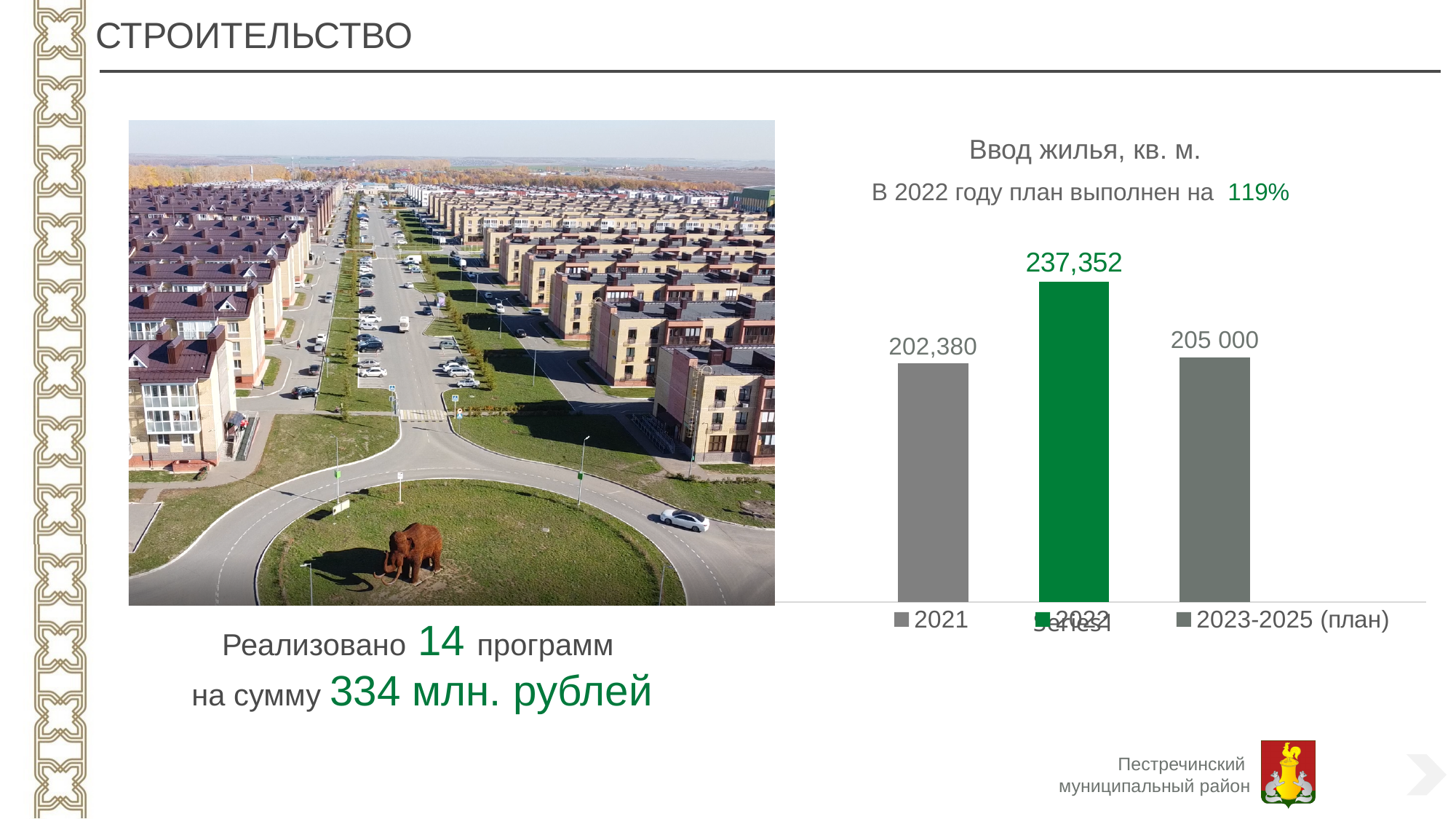
What is the difference between the 2022 value and the 2023-2025 (план) value in the chart 'Ввод жилья, кв. м.'? 32,352 What is the value for 2022 in the chart 'Ввод жилья, кв. м.'? 237,352 What kind of chart is 'Ввод жилья, кв. м.'? Bar chart What is the value for 2021 in the chart 'Ввод жилья, кв. м.'? 202,380 Which category has the highest value in the chart 'Ввод жилья, кв. м.'? 2022 What is the value for 2023-2025 (план) in the chart 'Ввод жилья, кв. м.'? 205 000 How many bars are shown in the chart 'Ввод жилья, кв. м.'? 3 What is the difference between the 2022 value and the 2021 value in the chart 'Ввод жилья, кв. м.'? 34,972 Which bar in the chart 'Ввод жилья, кв. м.' is coloured green? 2022 Which category has the lowest value in the chart 'Ввод жилья, кв. м.'? 2021 What is the title of the chart on the slide? Ввод жилья, кв. м. In the chart 'Ввод жилья, кв. м.', which is larger: the value for 2022 or the value for 2023-2025 (план)? 2022